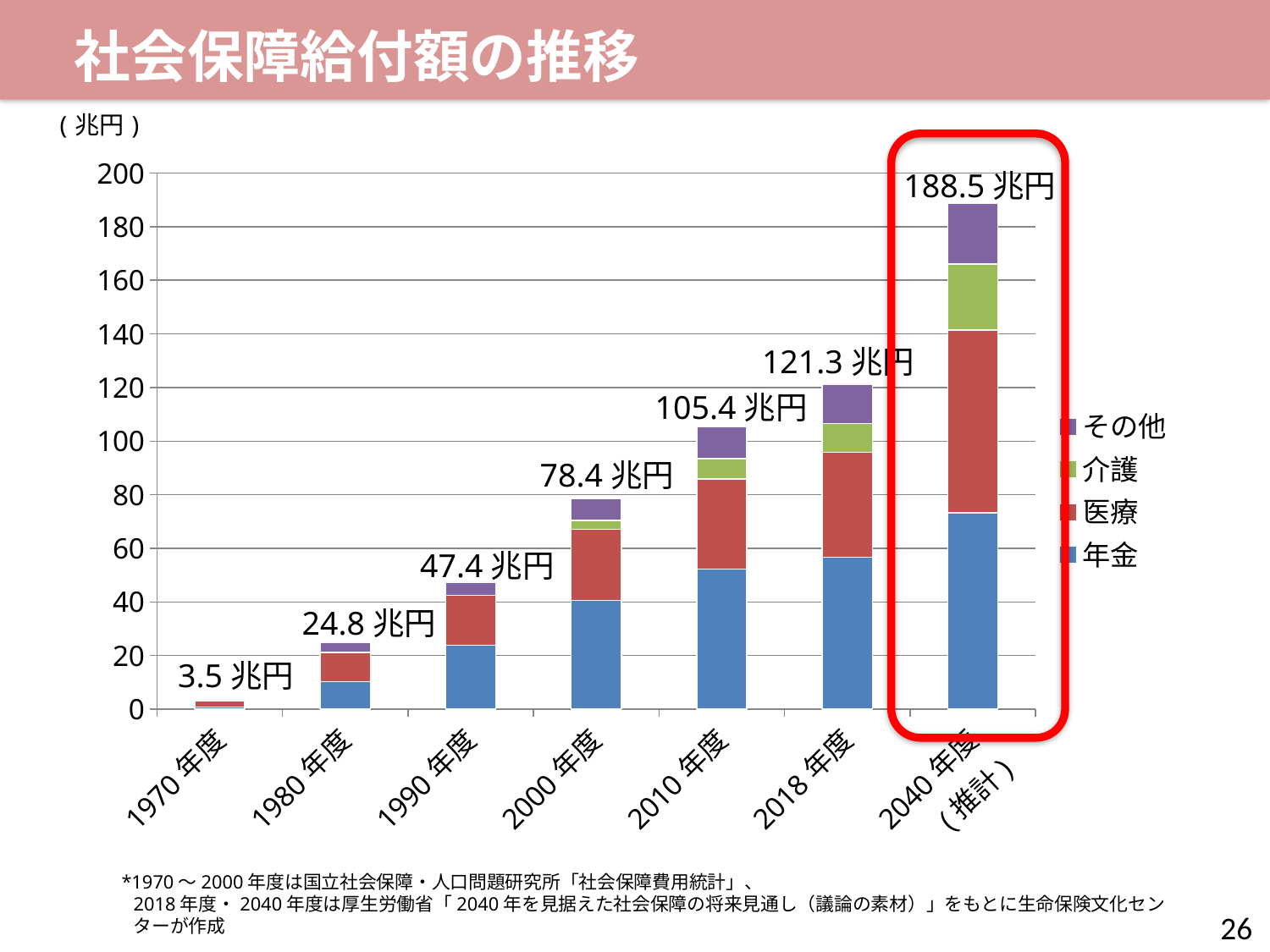
What kind of chart is shown on the slide? stacked bar chart How many fiscal years are shown on the x axis? 7 What is the total value labeled for 2000年度? 78.4 兆円 Do the total social security benefits rise or fall from 1970年度 to 2040年度(推計)? rise Is the value of 年金 for 2040年度(推計) greater or less than 60? greater What is the total social security benefit shown for 2040年度(推計)? 188.5 兆円 What is the difference between the total for 2040年度(推計) and the total for 2018年度? 67.2 兆円 How many series does the legend list? 4 What is the total value labeled for 1980年度? 24.8 兆円 Which is larger, the total for 2010年度 or the total for 1990年度? 2010年度 Which fiscal year has the highest total social security benefit? 2040年度(推計) Which fiscal year has the lowest total social security benefit? 1970年度